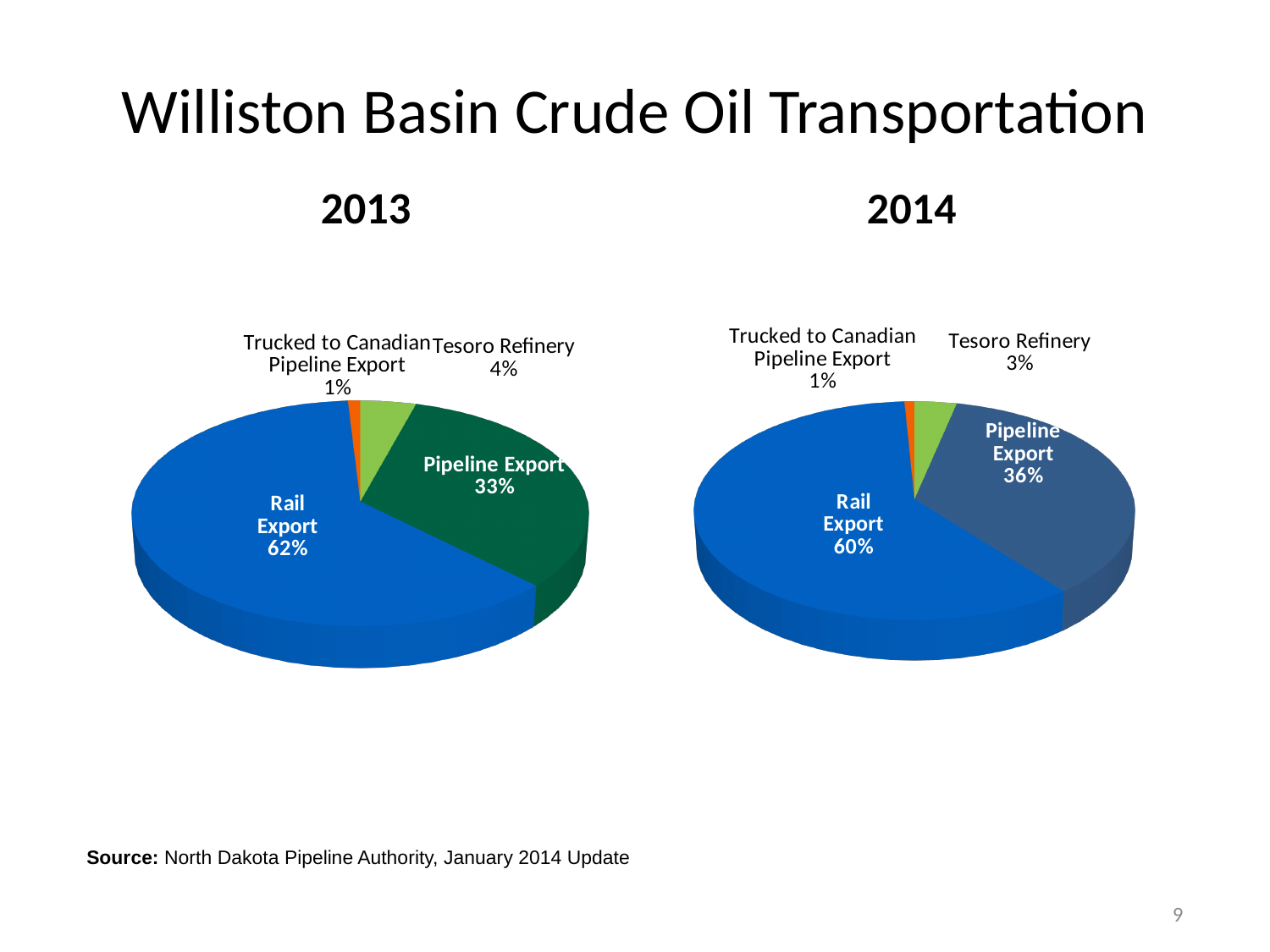
What type of chart is used for the 2013 data? Pie chart In the 2014 pie chart, what is the combined share of Tesoro Refinery and Trucked to Canadian Pipeline Export? 4% What is the title of the slide containing the two pie charts? Williston Basin Crude Oil Transportation In the 2014 pie chart, which category has the largest share? Rail Export In the 2014 pie chart, what share does Pipeline Export have? 36% In the 2013 pie chart, which category has the smallest share? Trucked to Canadian Pipeline Export In the 2014 pie chart, what share does Trucked to Canadian Pipeline Export have? 1% In the 2013 pie chart, what is the difference between the Rail Export and Pipeline Export shares? 29% Is the Pipeline Export share larger in the 2013 pie chart or the 2014 pie chart? 2014 How many categories does the 2014 pie chart show? 4 In the 2013 pie chart, what share does Tesoro Refinery have? 4% In the 2013 pie chart, what share does Rail Export have? 62%